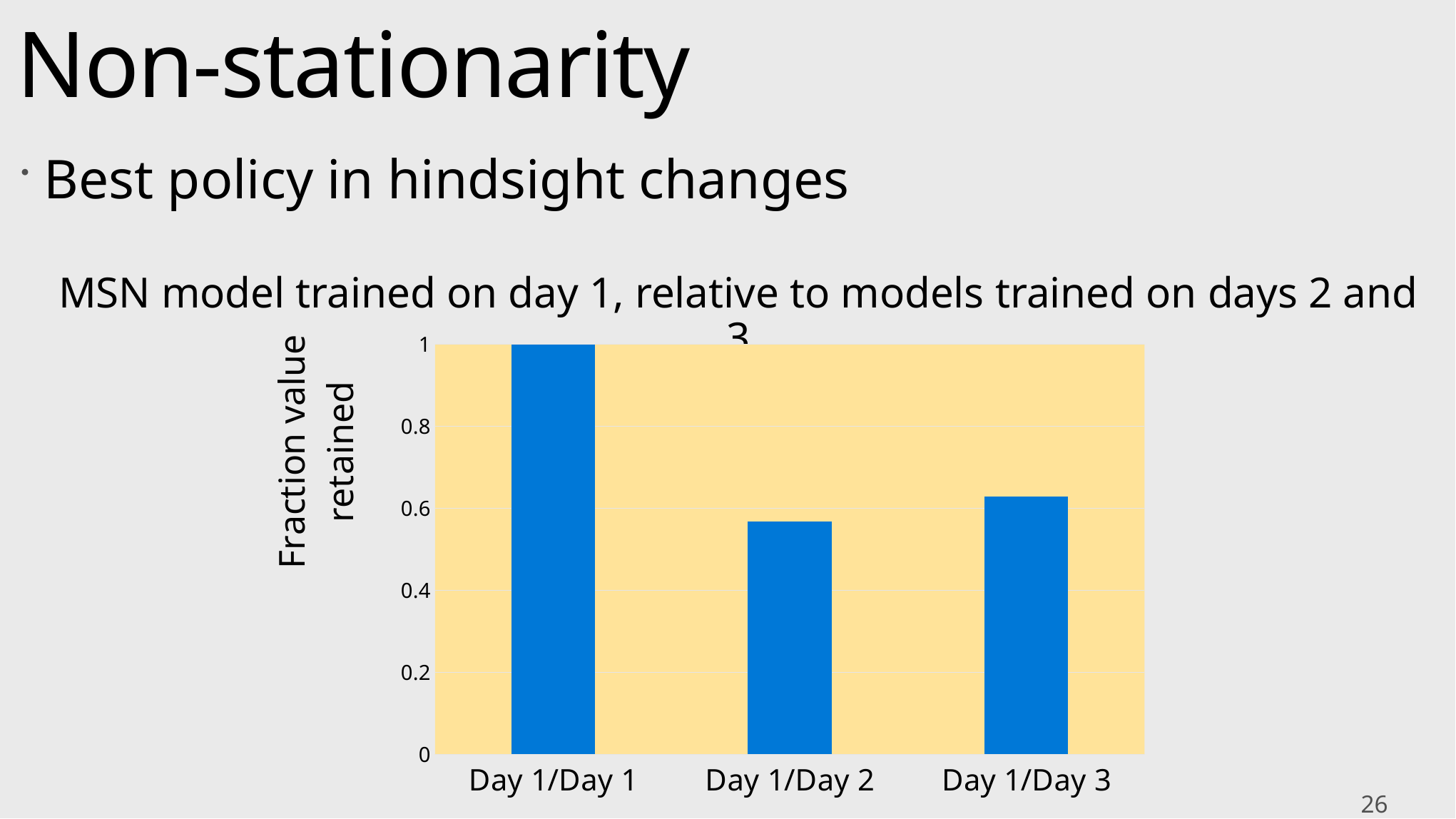
What is the label of the vertical axis of the chart? Fraction value retained What type of chart is shown on the slide? Bar chart Which category has the highest fraction value retained? Day 1/Day 1 How many bars are plotted in the chart? 3 Which category has the lowest fraction value retained? Day 1/Day 2 What is the title of the chart? MSN model trained on day 1, relative to models trained on days 2 and 3 What is the fraction value retained for Day 1/Day 1? 1 Is the value for Day 1/Day 3 greater or less than 0.6? greater Is the value for Day 1/Day 3 greater or less than 0.8? less Which is larger, the value for Day 1/Day 2 or the value for Day 1/Day 3? Day 1/Day 3 Is the value for Day 1/Day 2 greater or less than 0.6? less